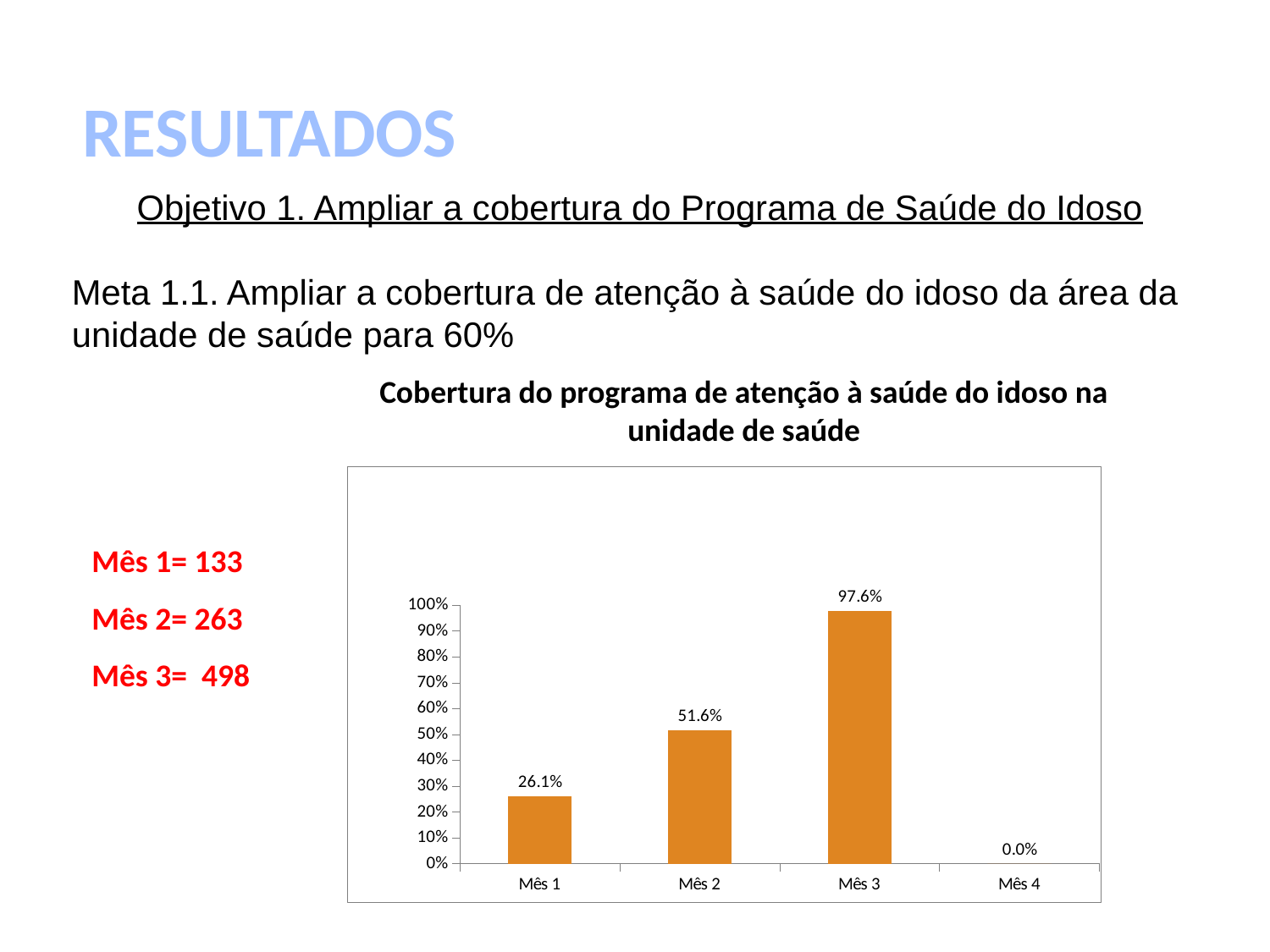
What is the value for Mês 4? 0.0% What is the title of the chart? Cobertura do programa de atenção à saúde do idoso na unidade de saúde Is the value for Mês 2 greater or less than 60%? less Which is larger, the value for Mês 1 or the value for Mês 2? Mês 2 Which month has the highest value? Mês 3 What is the value for Mês 2? 51.6% Which month has the lowest value? Mês 4 What kind of chart is shown on the slide? bar chart What is the value for Mês 3? 97.6% What is the difference between the values for Mês 3 and Mês 2? 46.0% What is the value for Mês 1? 26.1% How many categories are shown on the x axis? 4